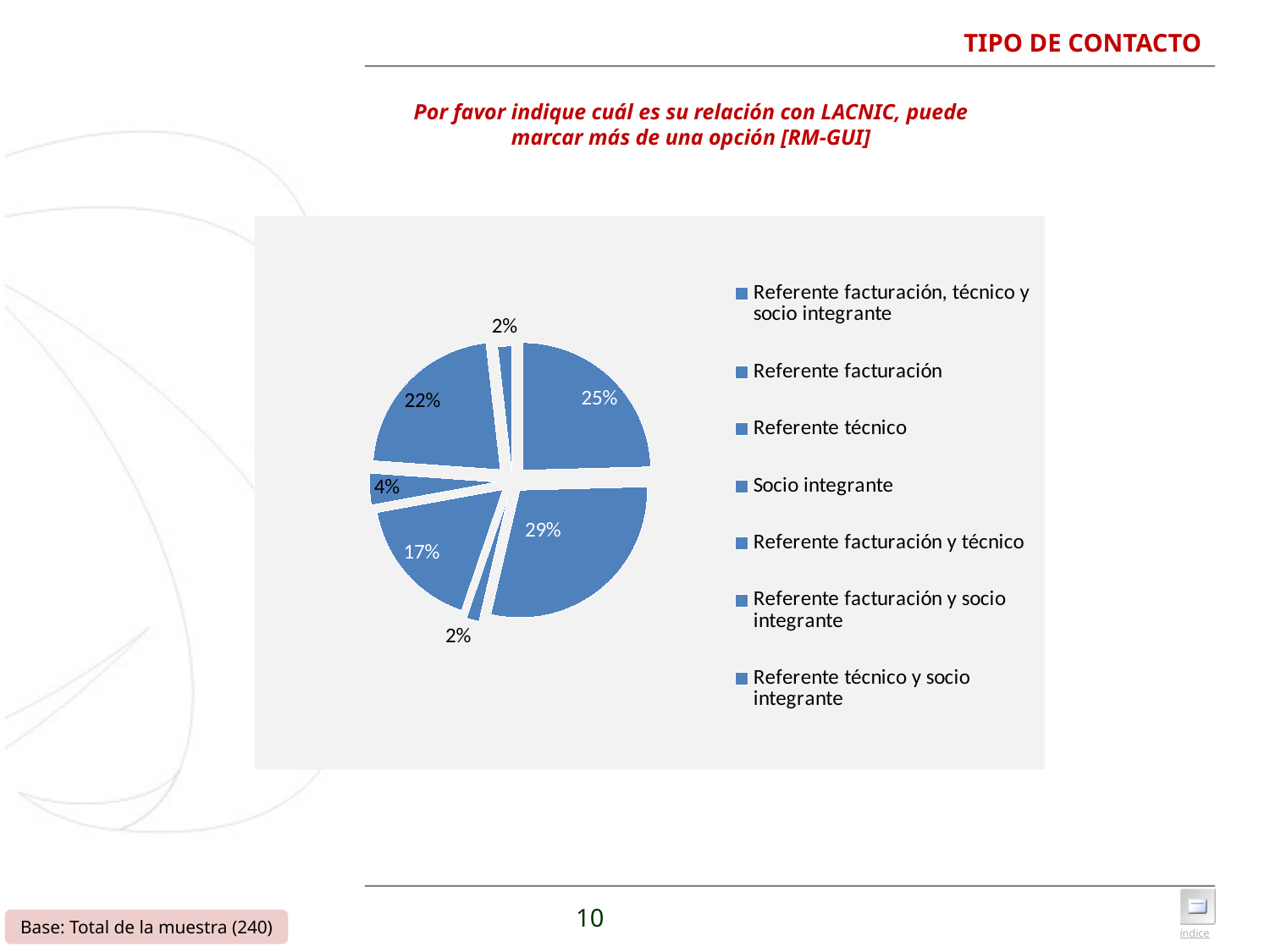
How many slices does the pie chart have? 7 What is the percentage shown on the smallest slices of the pie chart? 2% What is the first entry listed in the legend of the pie chart? Referente facturación, técnico y socio integrante What kind of chart is shown on the slide? pie chart What is the difference between the 22% slice and the 17% slice in the pie chart? 5% What is the base (sample size) stated at the bottom of the slide? Total de la muestra (240) What is the combined share of the 25% and 29% slices in the pie chart? 54% What is the difference between the largest slice (29%) and the 25% slice in the pie chart? 4% How many entries does the legend of the pie chart list? 7 Which is larger in the pie chart, the 22% slice or the 17% slice? 22% What is the percentage shown on the largest slice of the pie chart? 29% How many slices in the pie chart are labelled 2%? 2